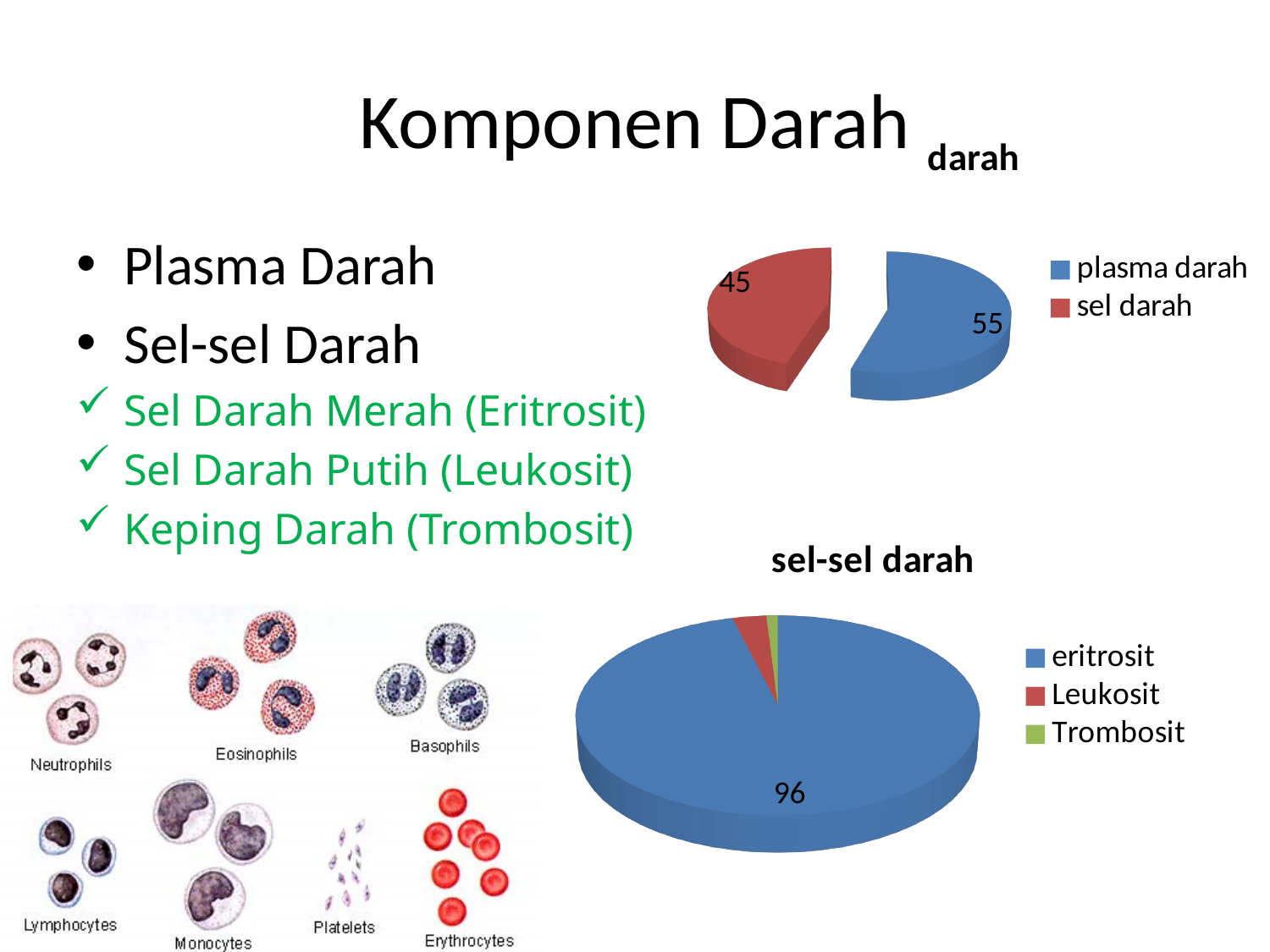
In the "darah" chart, what is the value for sel darah? 45 In the "darah" chart, what is the value for plasma darah? 55 In the "darah" chart, what colour is the sel darah slice? red In the "sel-sel darah" chart, how many entries does the legend list? 3 In the "sel-sel darah" chart, what is the value for eritrosit? 96 In the "sel-sel darah" chart, which category has the largest slice? eritrosit What is the title of the bottom pie chart? sel-sel darah In the "sel-sel darah" chart, which is larger, eritrosit or Leukosit? eritrosit In the "darah" chart, how many slices does the pie have? 2 In the "darah" chart, what is the difference between the plasma darah and sel darah values? 10 In the "darah" chart, which category has the larger value? plasma darah What kind of chart is the "darah" chart? pie chart